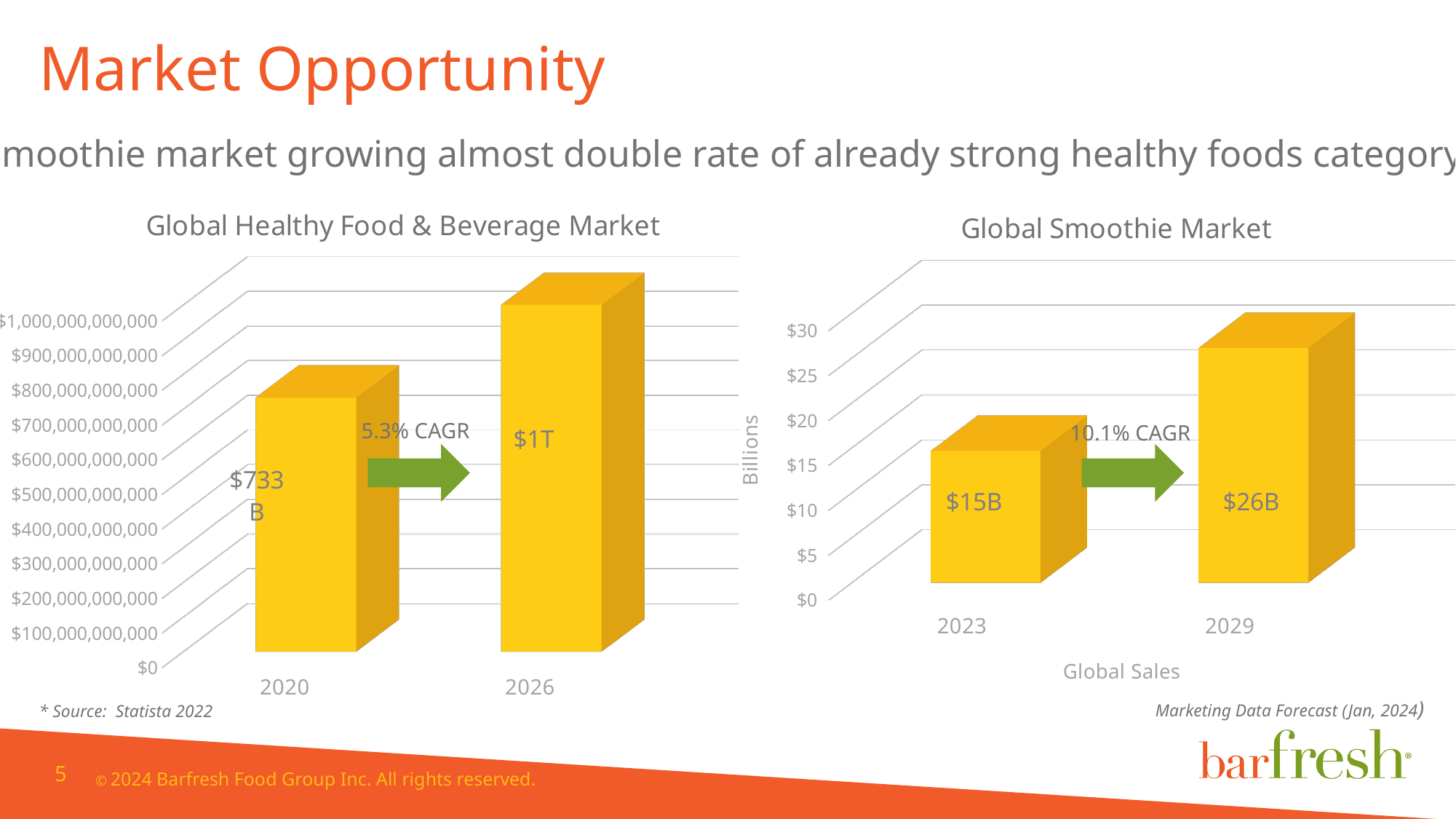
How many years are shown in the Global Healthy Food & Beverage Market chart? 2 In the Global Healthy Food & Beverage Market chart, which year has the higher value, 2020 or 2026? 2026 In the Global Smoothie Market chart, is the value for 2023 greater or less than $20? less In the Global Healthy Food & Beverage Market chart, what is the value for 2020? $733B In the Global Healthy Food & Beverage Market chart, what is the value for 2026? $1T In the Global Smoothie Market chart, which year has the lowest value? 2023 What kind of chart is the Global Smoothie Market chart? bar chart What CAGR is shown on the Global Smoothie Market chart? 10.1% CAGR In the Global Smoothie Market chart, what is the value for 2029? $26B In the Global Smoothie Market chart, do the values rise or fall from 2023 to 2029? rise In the Global Smoothie Market chart, what is the difference between the 2029 and 2023 values? $11B In the Global Smoothie Market chart, what is the value for 2023? $15B